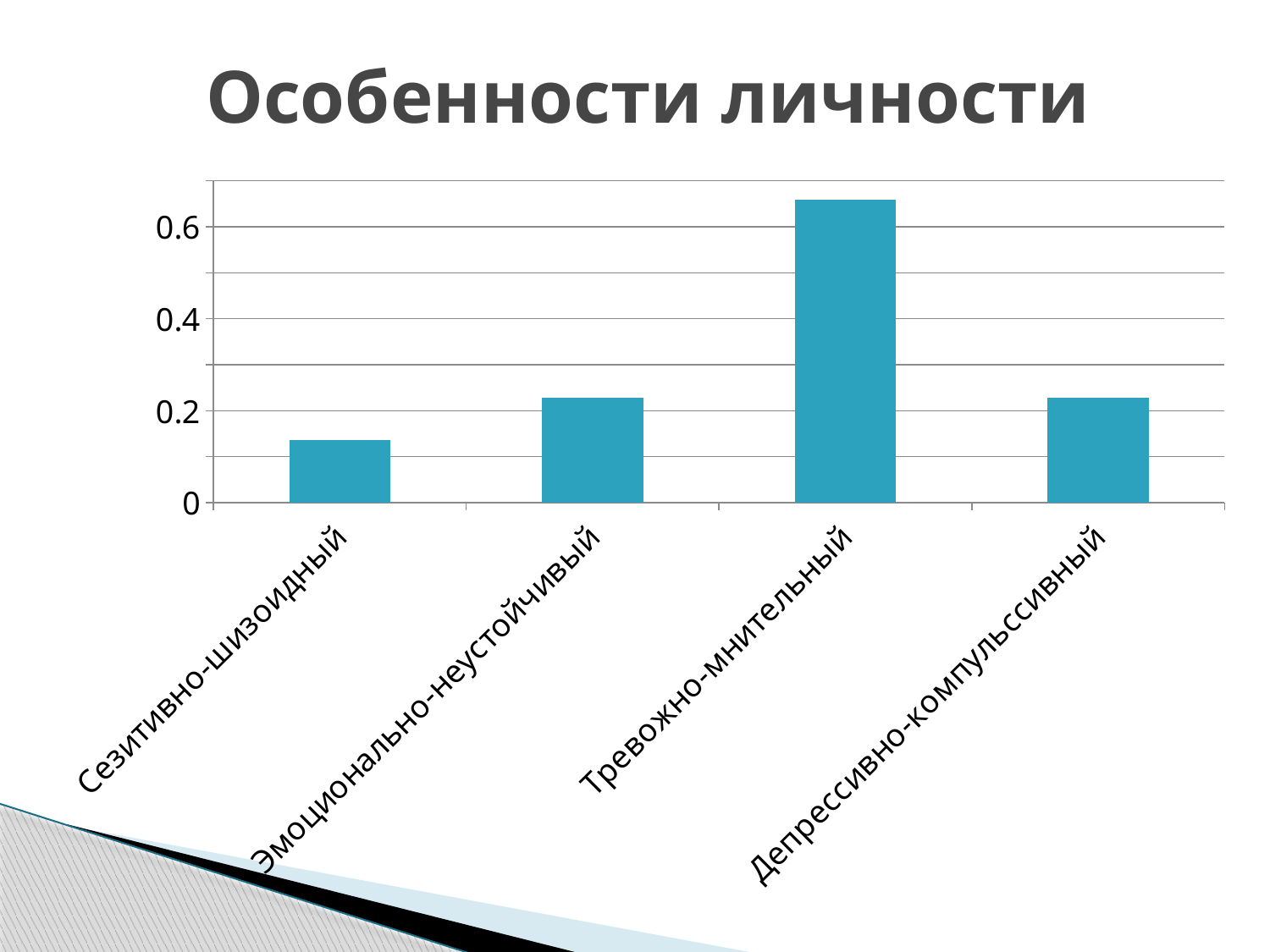
What is the title of the slide above the chart? Особенности личности Which is larger, the value for Эмоционально-неустойчивый or the value for Сезитивно-шизоидный? Эмоционально-неустойчивый How many categories are plotted on the chart? 4 Is the value for Эмоционально-неустойчивый greater or less than 0.2? greater Is the value for Тревожно-мнительный greater or less than 0.6? greater Is the value for Сезитивно-шизоидный greater or less than 0.2? less Which category has the lowest value? Сезитивно-шизоидный What kind of chart is shown on the slide? bar chart Which is larger, the value for Тревожно-мнительный or the value for Сезитивно-шизоидный? Тревожно-мнительный Which category has the highest value? Тревожно-мнительный What is the highest value labelled on the vertical axis? 0.6